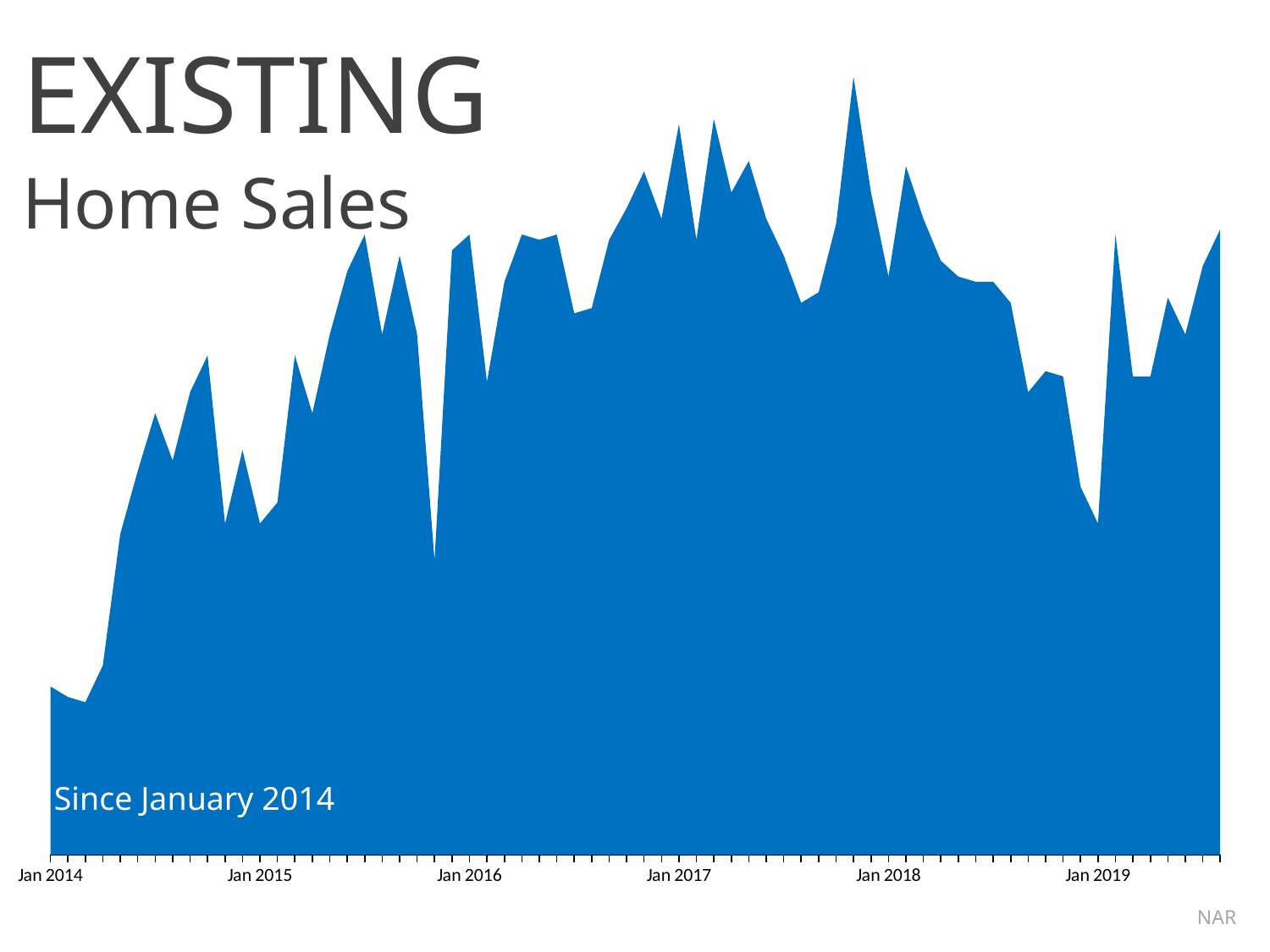
At which x-axis label is the lowest value of the chart? Jan 2014 What is the title of the chart on the slide? EXISTING Home Sales Is the value at Jan 2016 higher or lower than the value at Jan 2014? Higher Do the values generally rise or fall from Jan 2018 to Jan 2019? Fall Is the value at Jan 2019 higher or lower than the value at Jan 2014? Higher What is the first date label on the x axis of the chart? Jan 2014 How many year labels are shown on the x axis of the chart? 6 Do the values generally rise or fall from Jan 2014 to Jan 2015? Rise Between which two x-axis labels does the highest peak of the chart occur? Jan 2017 and Jan 2018 What source is credited for the chart data? NAR Which x-axis label marks the last year shown on the chart? Jan 2019 What kind of chart is shown on the slide? Area chart